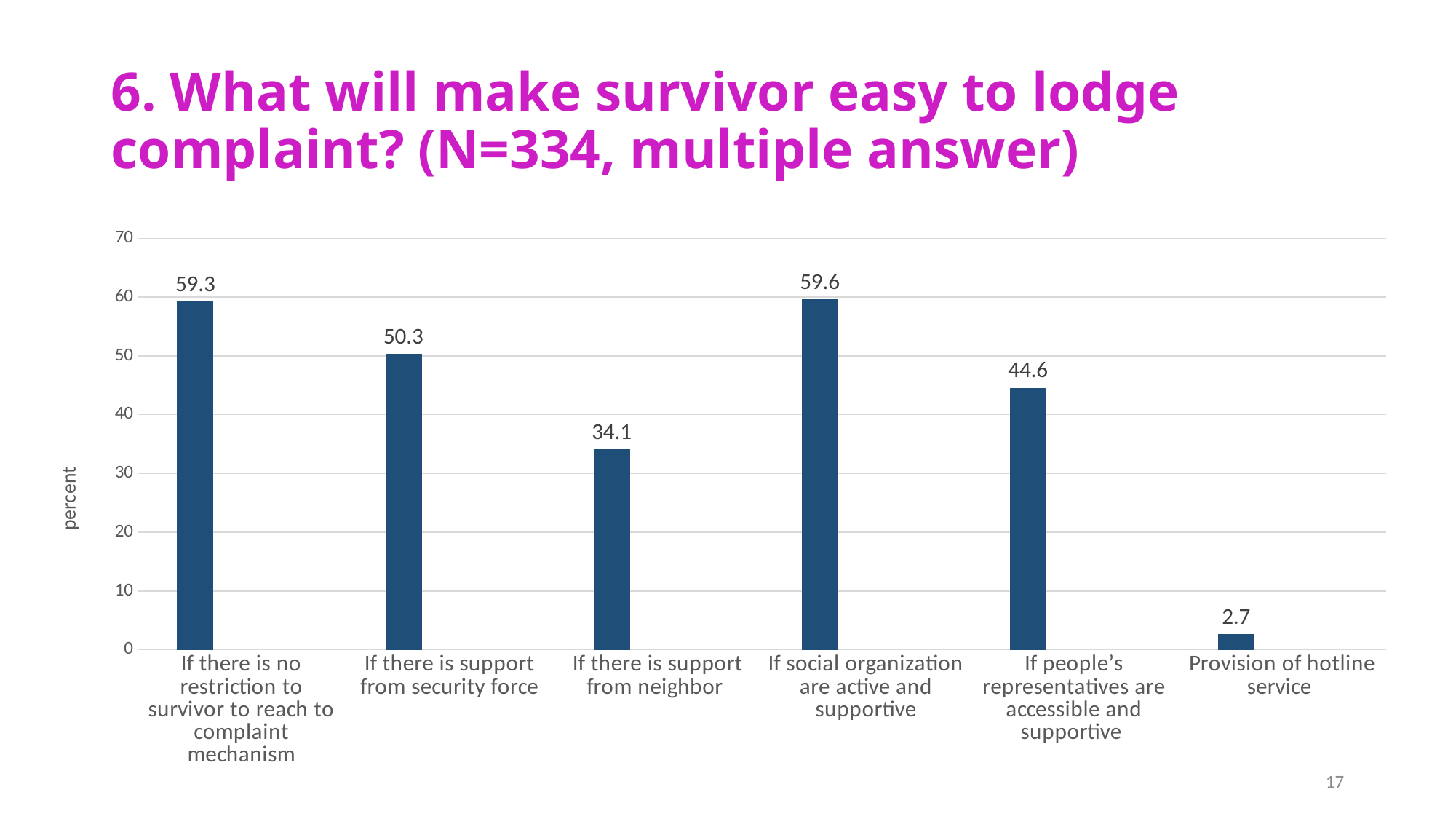
Which category has the highest value? If social organization are active and supportive Which category has the lowest value? Provision of hotline service What is the value for 'If people's representatives are accessible and supportive'? 44.6 Which is larger: the value for 'If there is support from security force' or 'If people's representatives are accessible and supportive'? If there is support from security force Is the value for 'If there is support from neighbor' greater or less than 40? less What is the value for 'If there is support from neighbor'? 34.1 What is the value for 'If there is support from security force'? 50.3 What is the difference between the values for 'If there is support from security force' and 'If there is support from neighbor'? 16.2 What kind of chart is shown on the slide? bar chart How many categories are shown in the chart? 6 What is the label of the vertical axis? percent What is the value for 'Provision of hotline service'? 2.7